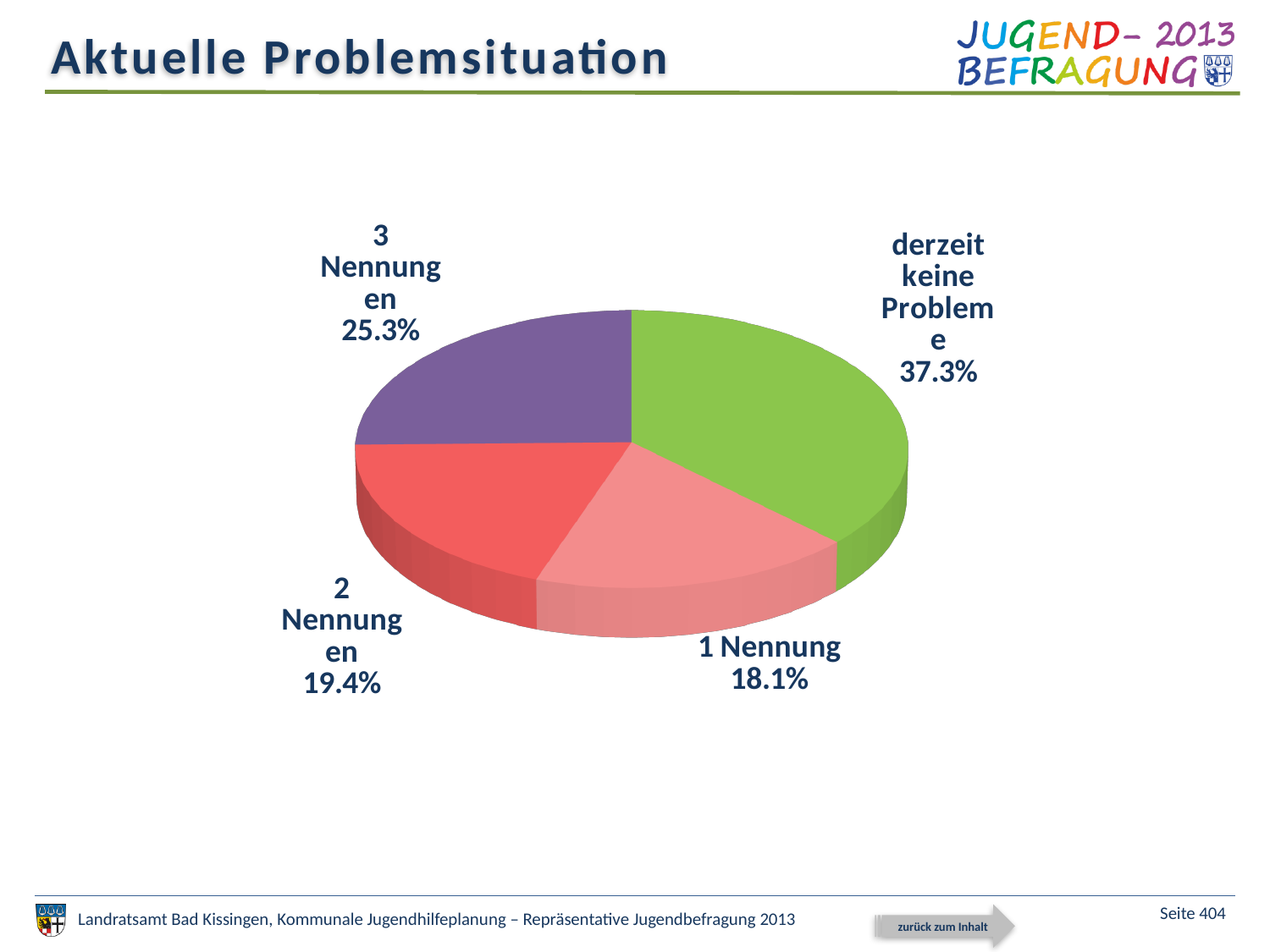
What colour is the slice for "3 Nennungen"? purple Which is larger, the share for "2 Nennungen" or the share for "1 Nennung"? 2 Nennungen What colour is the slice for "derzeit keine Probleme"? green What kind of chart is shown on the slide? pie chart How many slices does the pie chart have? 4 What share of the pie is labelled "2 Nennungen"? 19.4% What share of the pie is labelled "derzeit keine Probleme"? 37.3% Which slice of the pie is the smallest? 1 Nennung What share of the pie is labelled "1 Nennung"? 18.1% What share of the pie is labelled "3 Nennungen"? 25.3% Which slice of the pie is the largest? derzeit keine Probleme What is the difference in percentage points between "derzeit keine Probleme" and "3 Nennungen"? 12.0 percentage points